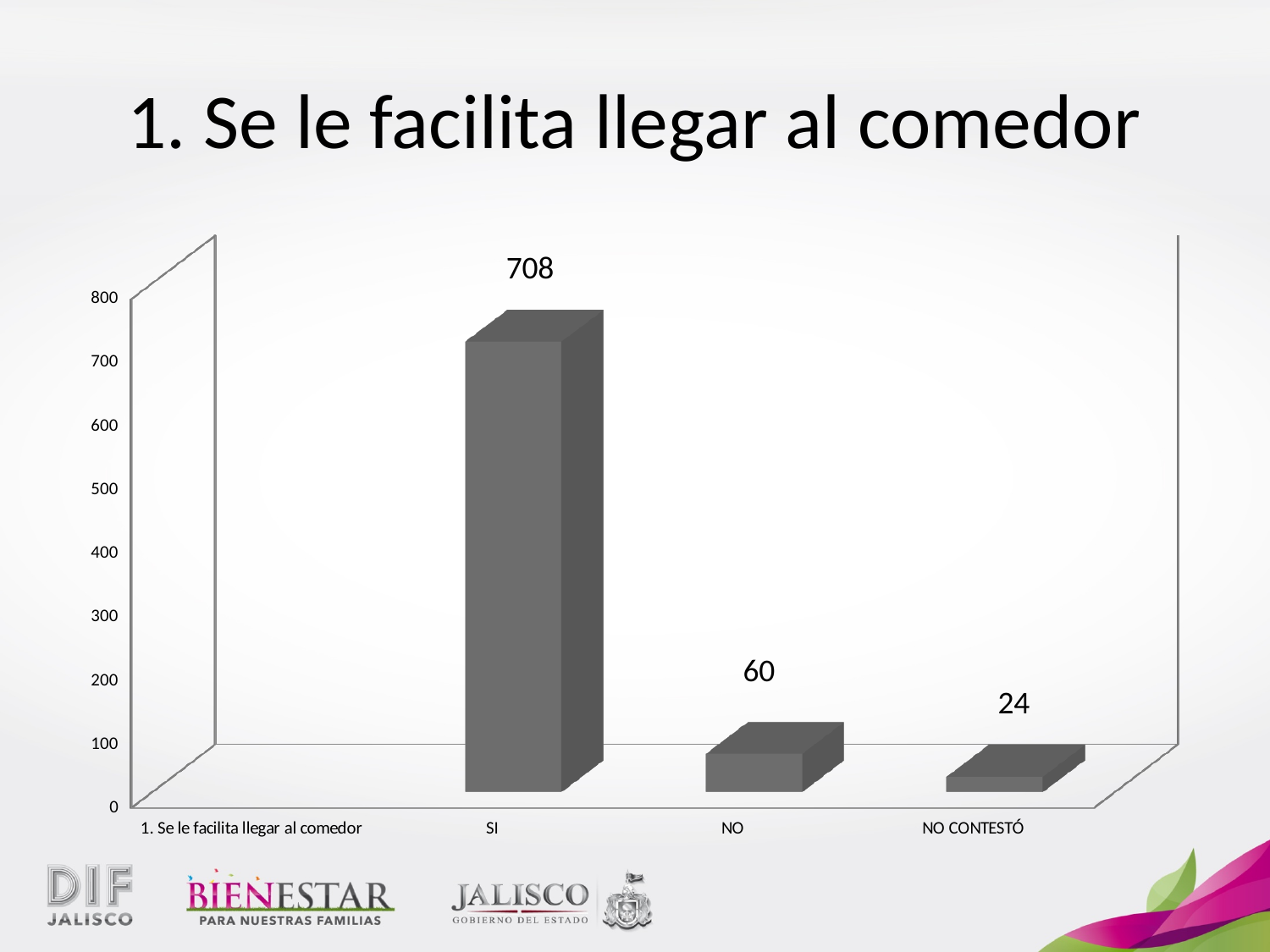
Which category has the highest value? SI Is the value for NO greater or less than 100? less What is the value for NO CONTESTÓ? 24 Which category has the lowest value? NO CONTESTÓ What is the difference between the values for NO and NO CONTESTÓ? 36 Is the value for SI greater or less than 500? greater How many bars are plotted on the chart? 3 What is the difference between the values for SI and NO? 648 Which is larger, the value for NO or the value for NO CONTESTÓ? NO What is the value for SI? 708 What is the value for NO? 60 What kind of chart is shown on the slide? bar chart